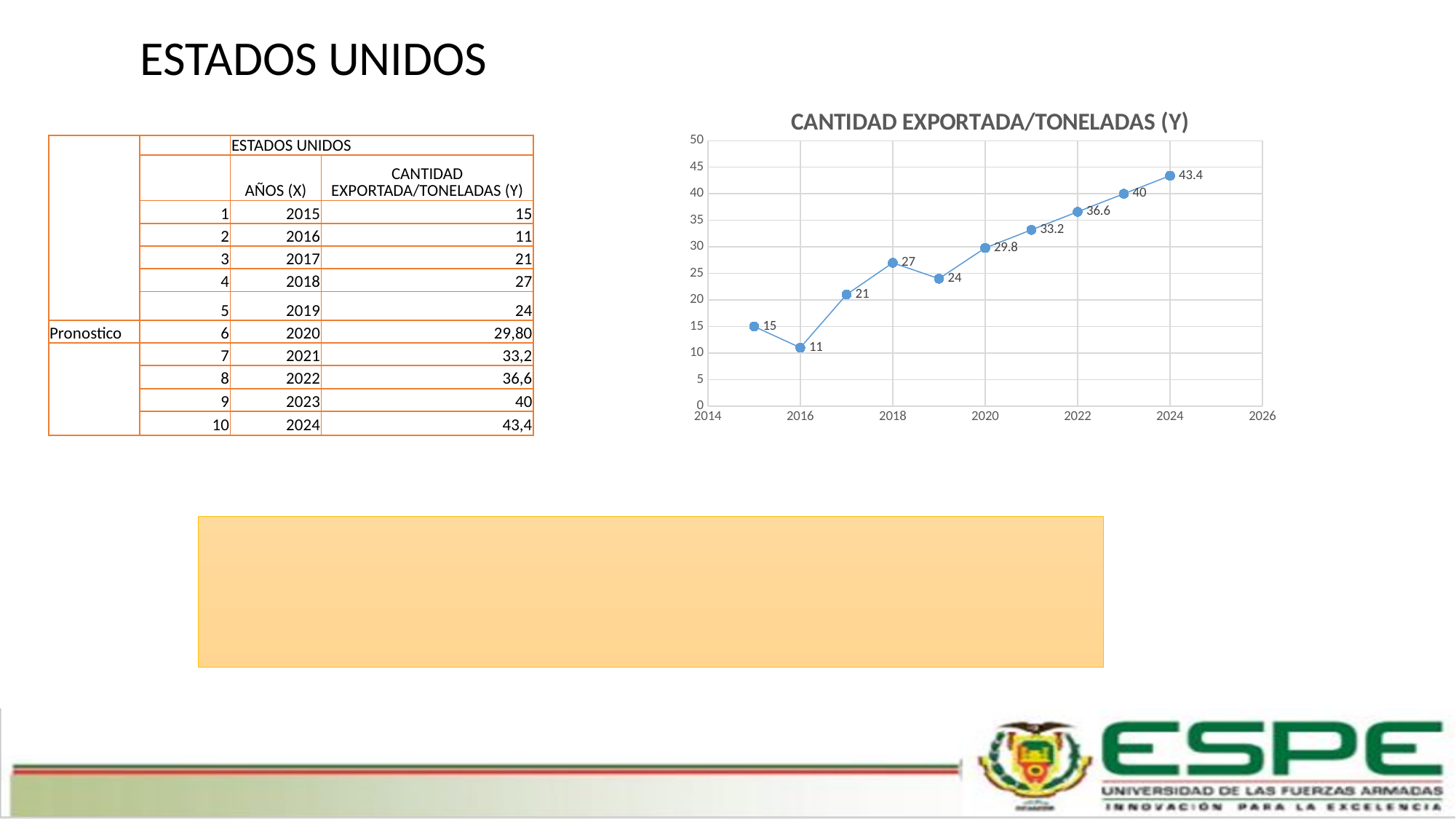
What is the value plotted for 2018 in the chart? 27 Which is larger, the value for 2018 or the value for 2019? 2018 What is the value plotted for 2022 in the chart? 36.6 How many data points are plotted in the chart? 10 What kind of chart is shown on the slide? line chart Which year has the highest value in the chart? 2024 Which year has the lowest value in the chart? 2016 What is the value plotted for 2020 in the chart? 29.8 Is the value for 2023 greater or less than 35? greater What is the title of the chart? CANTIDAD EXPORTADA/TONELADAS (Y) What is the difference between the values for 2024 and 2015? 28.4 Do the values generally rise or fall from 2016 to 2024? rise